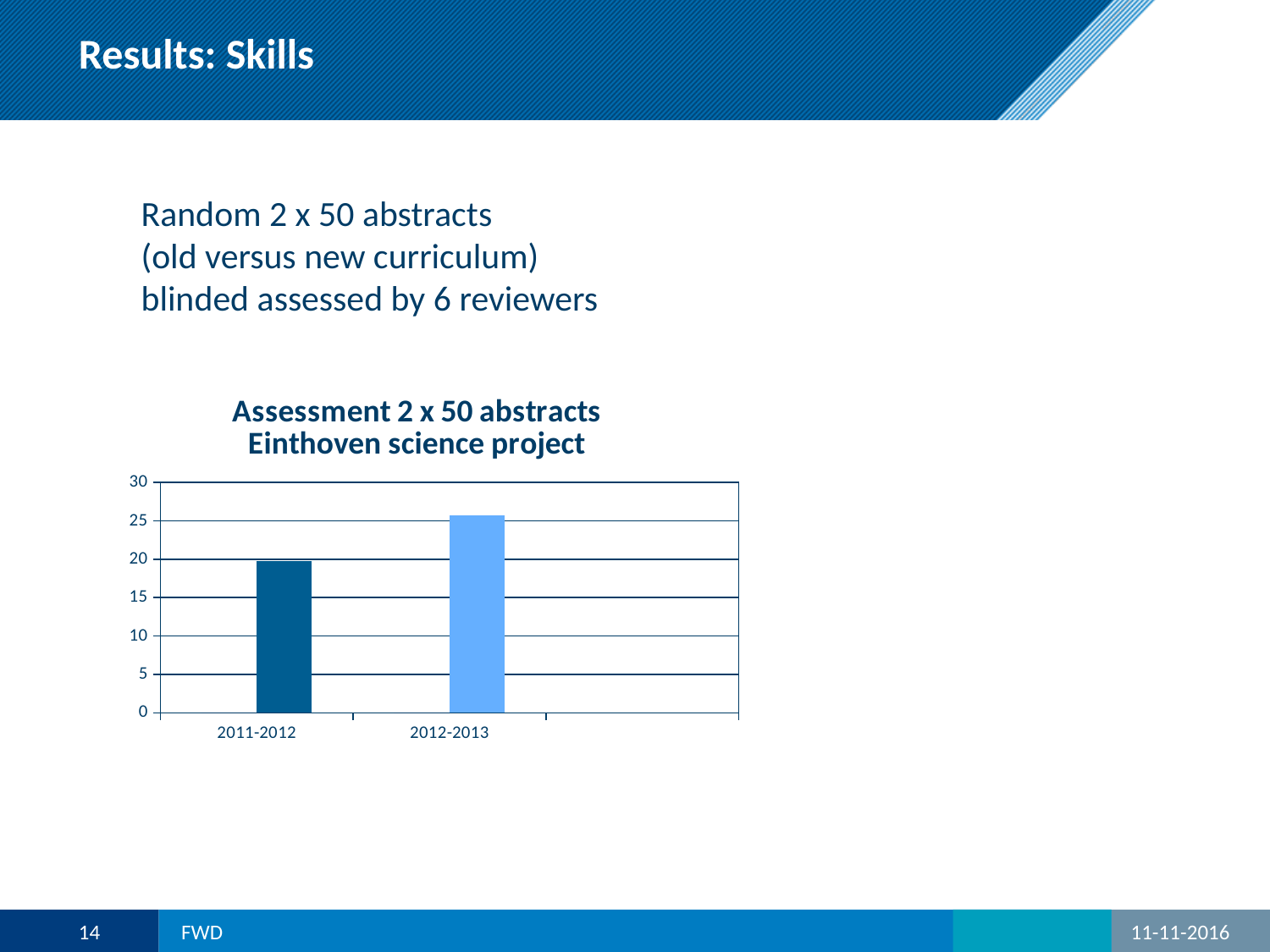
Do the values rise or fall from 2011-2012 to 2012-2013? rise Which bar is taller, 2011-2012 or 2012-2013? 2012-2013 How many categories are plotted on the x axis of the chart? 2 What kind of chart is shown on the slide? bar chart What is the title of the chart? Assessment 2 x 50 abstracts Einthoven science project Which category has the highest bar in the chart? 2012-2013 Is the value for 2011-2012 greater or less than 15? greater Is the value for 2012-2013 greater or less than 30? less What is the highest value shown on the chart's vertical axis? 30 Is the value for 2012-2013 greater or less than 20? greater Which category has the lowest bar in the chart? 2011-2012